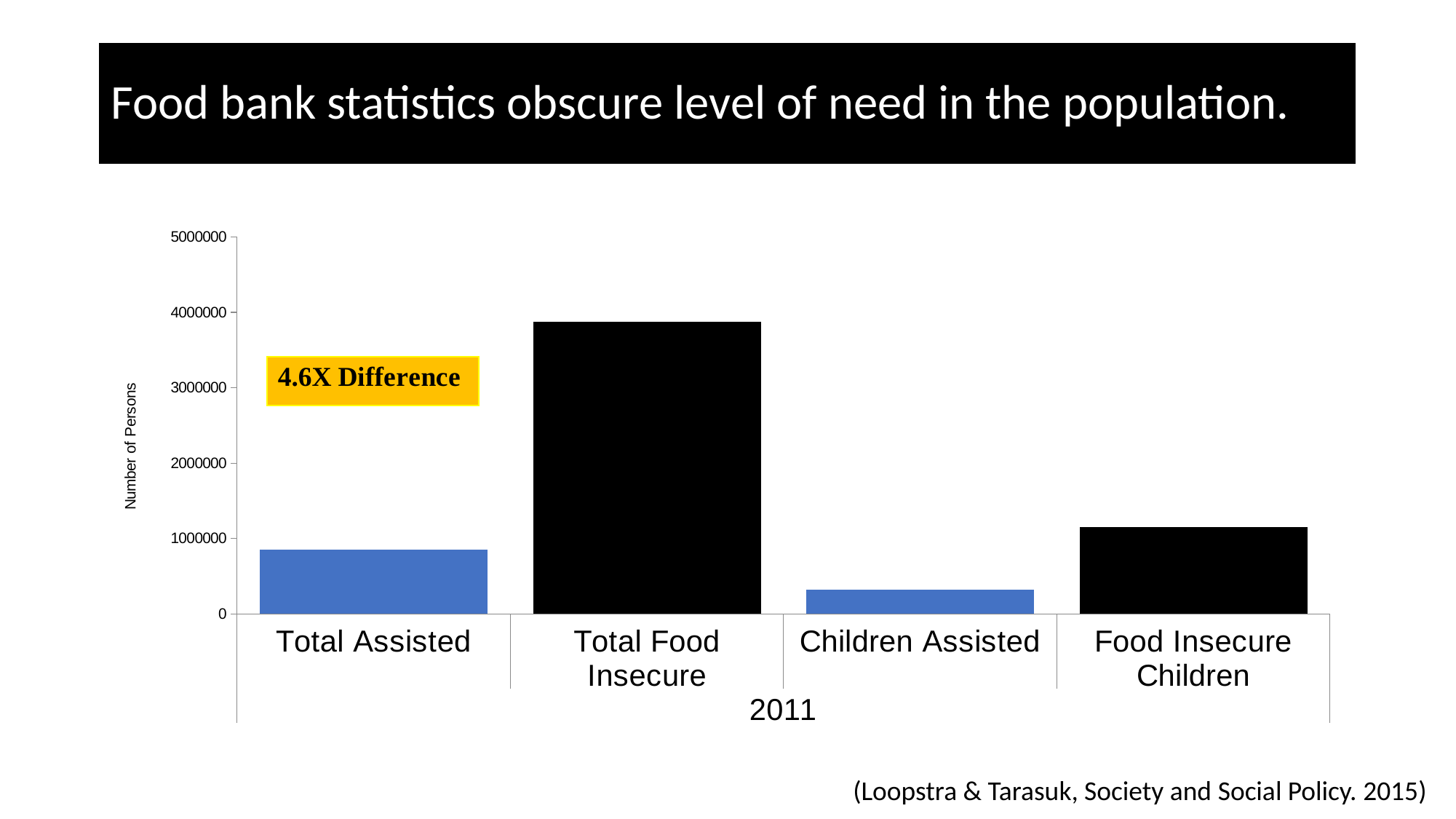
Is the value for Children Assisted greater or less than 1000000? less What does the yellow annotation box on the chart say? 4.6X Difference Which category has the lowest value? Children Assisted What kind of chart is shown on the slide? bar chart Is the value for Total Assisted greater or less than 1000000? less Which category has the highest value? Total Food Insecure What is the label on the vertical axis of the chart? Number of Persons How many categories are plotted on the chart? 4 Is the value for Food Insecure Children greater or less than 1000000? greater Which is larger, the value for Food Insecure Children or the value for Total Assisted? Food Insecure Children